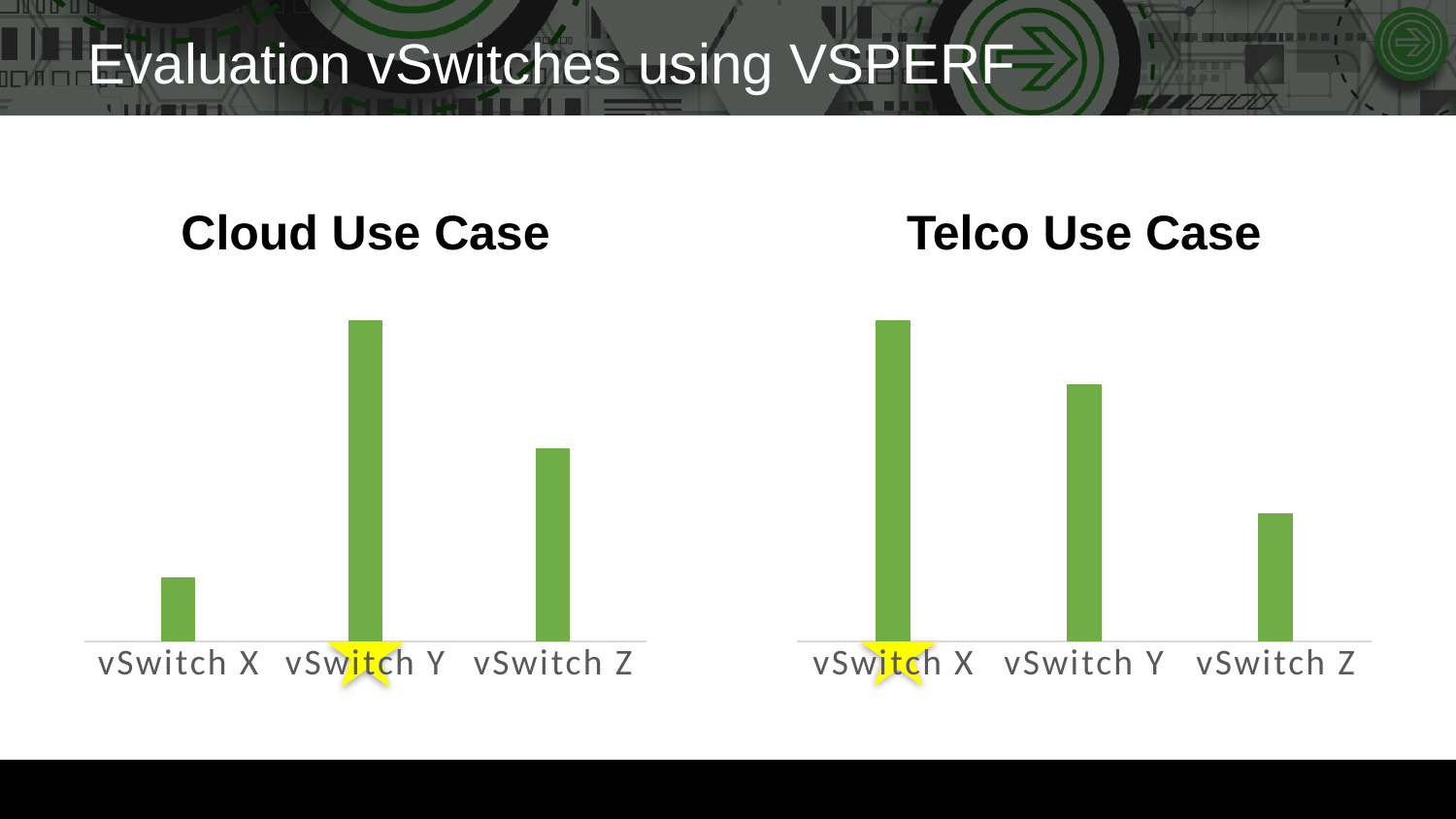
What is the title of the chart on the left side of the slide? Cloud Use Case In the Telco Use Case chart, which vSwitch has the lowest bar? vSwitch Z In the Telco Use Case chart, which is larger, the bar for vSwitch Y or the bar for vSwitch Z? vSwitch Y In the Cloud Use Case chart, which vSwitch has the lowest bar? vSwitch X How many categories are shown in the Cloud Use Case chart? 3 What kind of chart is the Telco Use Case chart? Bar chart In the Cloud Use Case chart, which vSwitch has the highest bar? vSwitch Y How many categories are shown in the Telco Use Case chart? 3 What is the title of the chart on the right side of the slide? Telco Use Case In the Cloud Use Case chart, which is larger, the bar for vSwitch Z or the bar for vSwitch X? vSwitch Z In the Telco Use Case chart, which vSwitch has the highest bar? vSwitch X